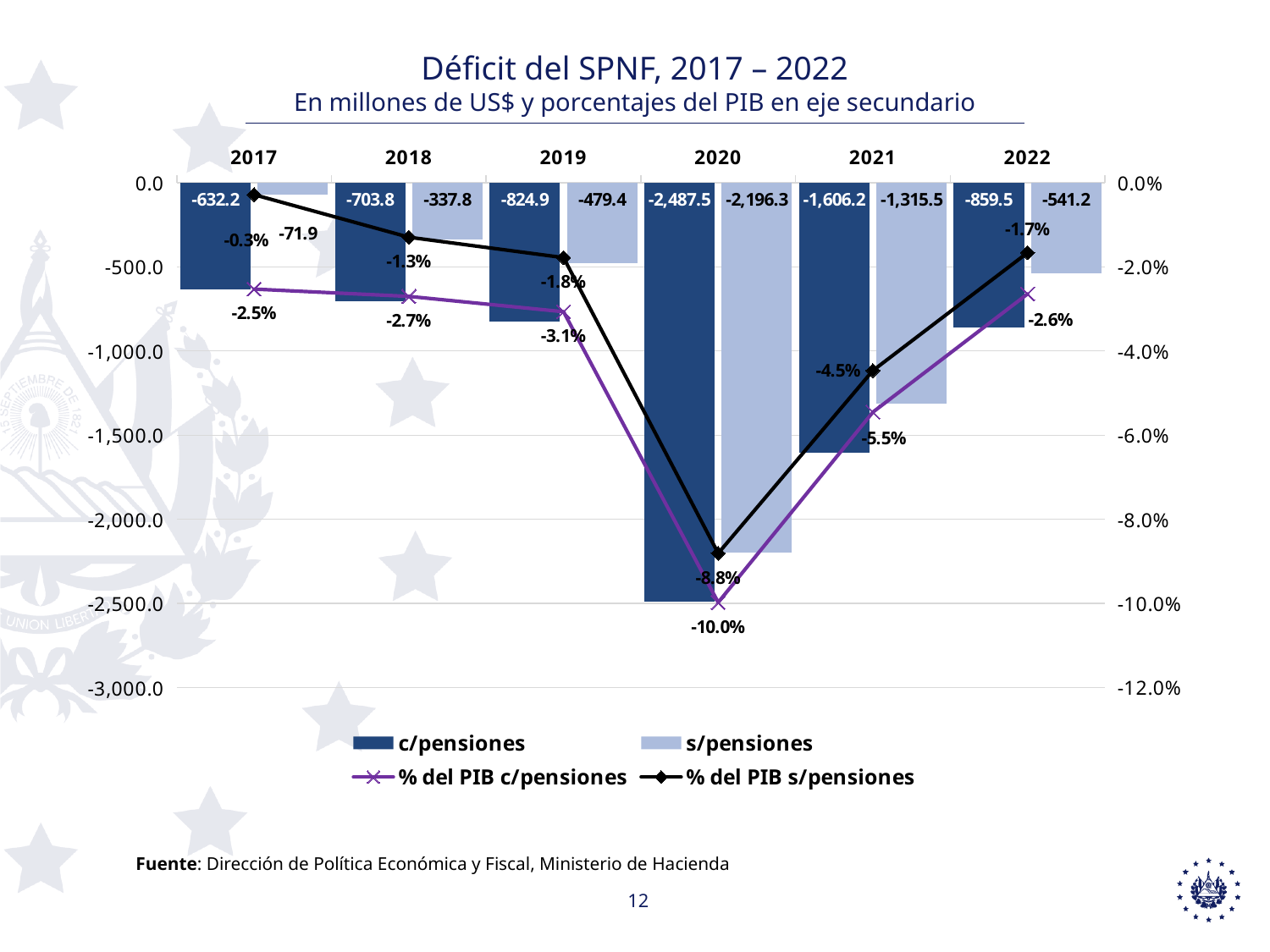
How many years are shown on the x axis? 6 What is the difference between the c/pensiones and s/pensiones values in 2022? 318.3 In which year is the c/pensiones value lowest (most negative)? 2020 In which year is the s/pensiones value highest (closest to zero)? 2017 What kind of chart is this? Combined bar and line chart What is the % del PIB c/pensiones value for 2021? -5.5% How many series does the legend list? 4 What is the % del PIB s/pensiones value for 2019? -1.8% What is the s/pensiones value for 2017? -71.9 Which is more negative in 2018: the c/pensiones value or the s/pensiones value? c/pensiones Does the % del PIB s/pensiones line rise or fall from 2020 to 2022? Rise What is the c/pensiones value for 2020? -2,487.5